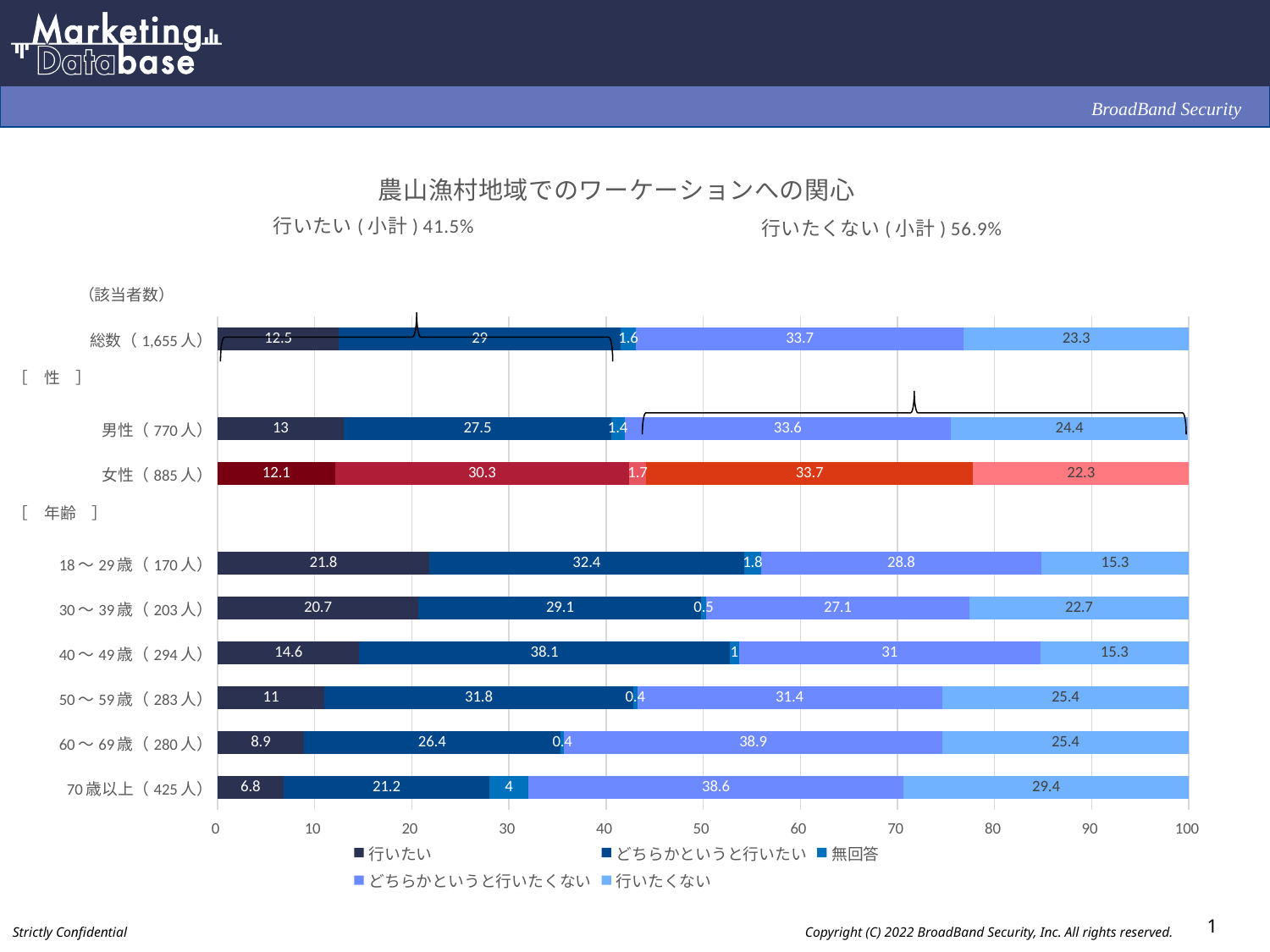
How many categories (bars) are plotted in the chart? 9 How many series does the legend list? 5 What is the 無回答 value for 女性? 1.7 What is the title of the chart? 農山漁村地域でのワーケーションへの関心 Which age group has the highest 行いたい value? 18～29歳 Which is larger, the どちらかというと行いたい value for 40～49歳 or for 50～59歳? 40～49歳 What is the difference between the 行いたくない values for 男性 and 女性? 2.1 What is the どちらかというと行いたくない value for 60～69歳? 38.9 Which age group has the lowest 行いたい value? 70歳以上 What is the 行いたい value for 18～29歳? 21.8 What is the 行いたくない value for 70歳以上? 29.4 What type of chart is shown on the slide? Stacked bar chart